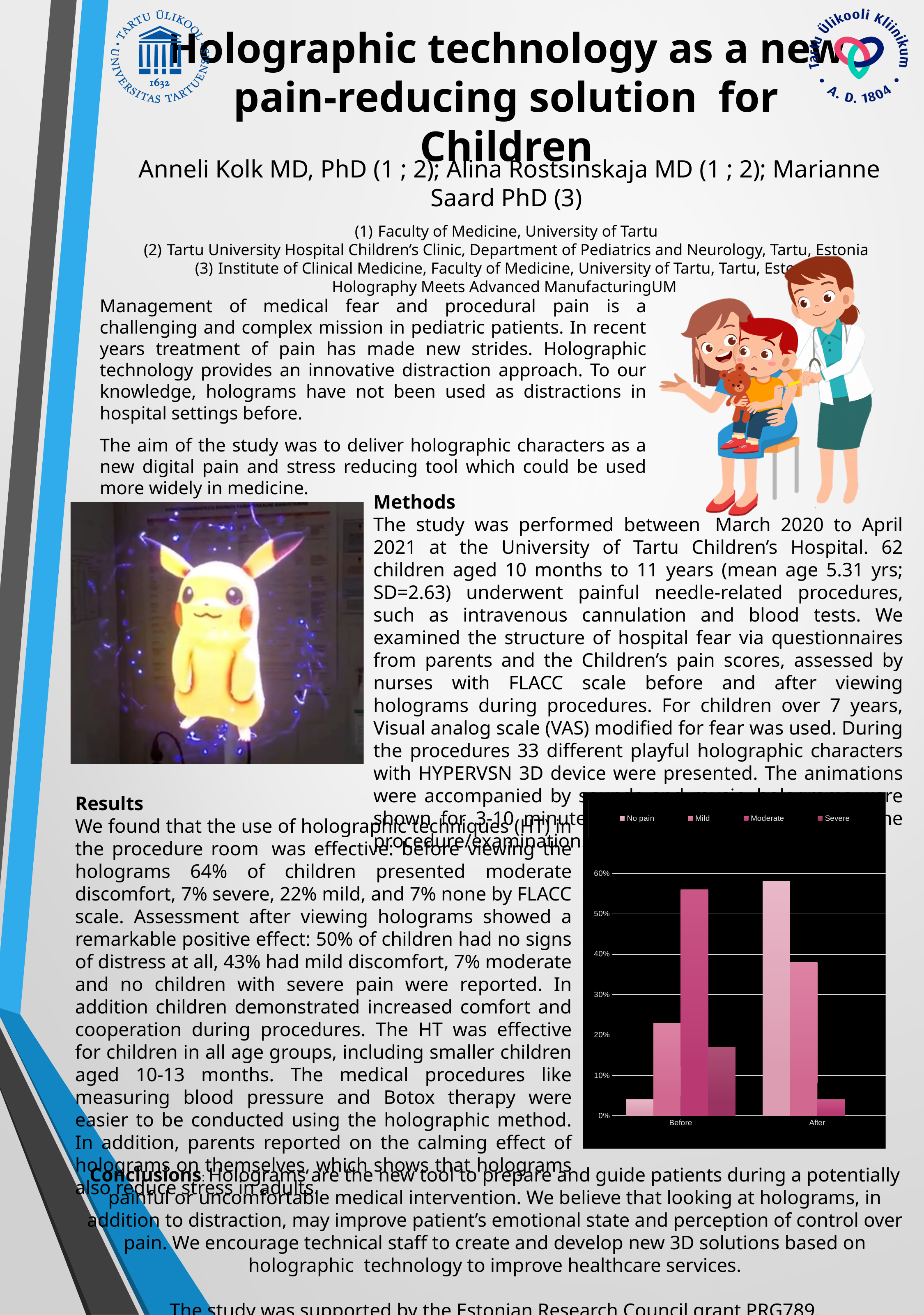
Is the value for No pain in the After category greater or less than 50%? greater Which series has the lowest bar in the Before category? No pain What are the four entries listed in the chart's legend? No pain, Mild, Moderate, Severe Is the value for Moderate in the Before category greater or less than 50%? greater How many categories are shown on the x axis of the chart? 2 Which series has the highest bar in the After category? No pain Which is larger, the Mild value for Before or the Mild value for After? After Which series has the lowest bar in the After category? Severe What kind of chart is shown on the slide? bar chart How many series does the chart's legend list? 4 Is the value for Mild in the Before category greater or less than 30%? less Which series has the highest bar in the Before category? Moderate